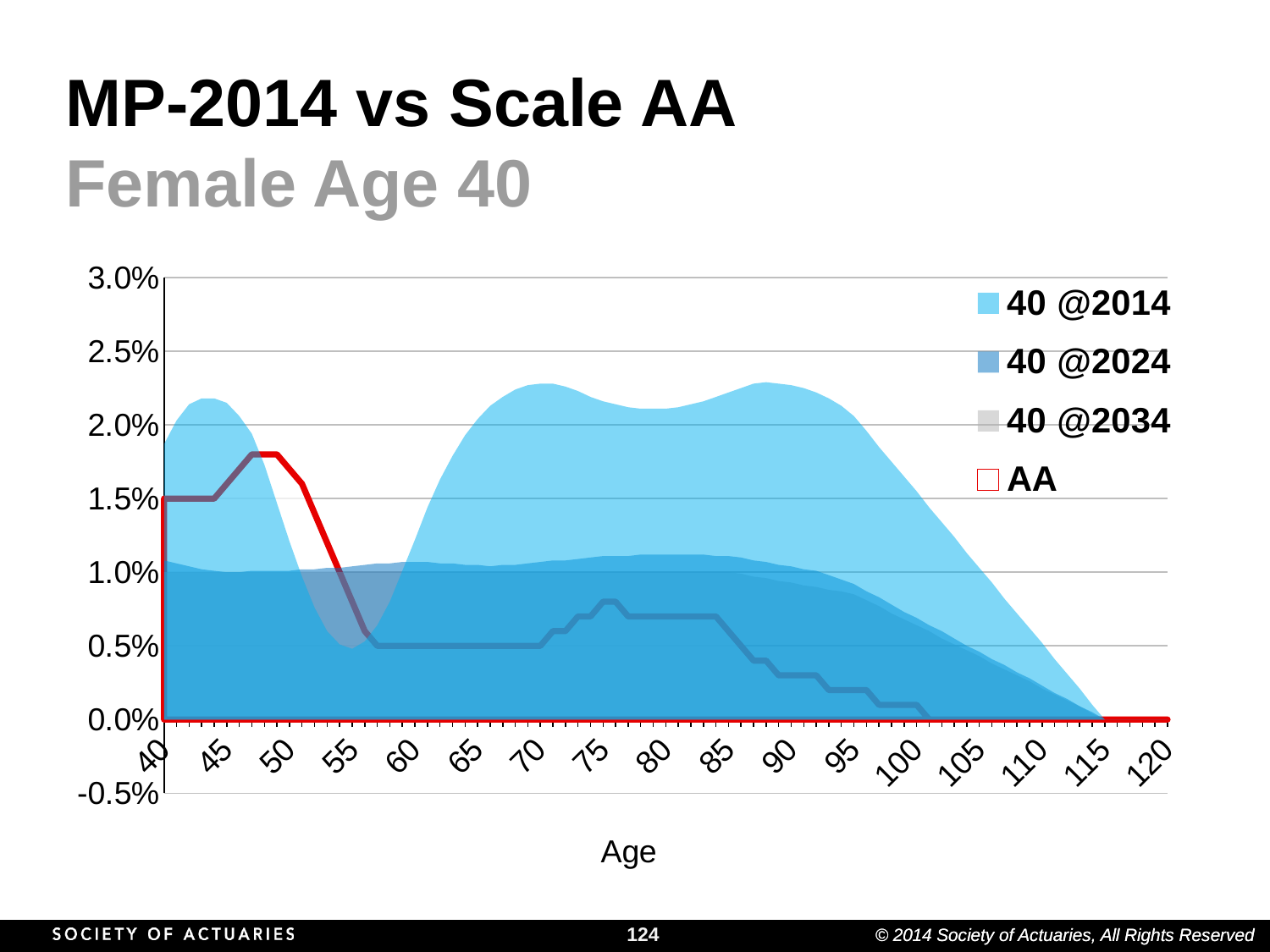
Is the value for AA at age 50 greater or less than 1.5%? greater Is the value for 40 @2014 at age 70 greater or less than 2.0%? greater Which series has the highest value at age 70? 40 @2014 Is the value for 40 @2024 at age 110 greater or less than 0.5%? less What kind of chart is shown on the slide? Area chart How many series does the chart legend list? 4 What is the label of the x axis? Age What is the highest value shown on the y axis? 3.0% Does the 40 @2014 series rise or fall between age 100 and age 115? fall At age 45, which is larger: 40 @2014 or AA? 40 @2014